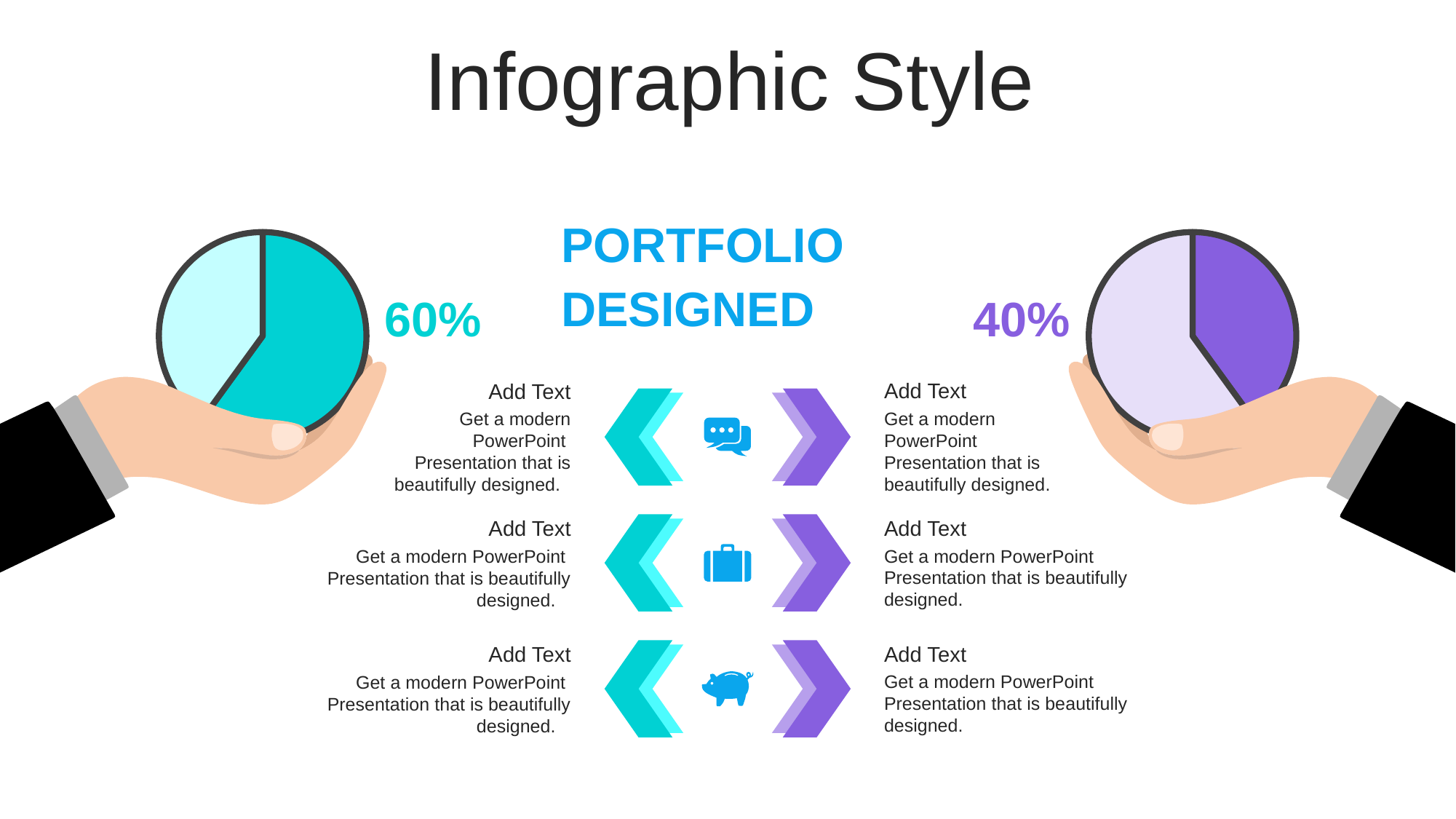
What kind of chart is shown on the right side of the slide? pie chart What kind of chart is shown on the left side of the slide? pie chart What is the difference between the percentage printed next to the left pie chart and the percentage printed next to the right pie chart? 20% What percentage is printed next to the left pie chart? 60% Which pie chart has the larger printed percentage, the left one or the right one? the left one What percentage is printed next to the right pie chart? 40% In the left pie chart, which slice is larger, the dark teal slice or the light teal slice? the dark teal slice What colour is the larger slice of the left pie chart? dark teal How many pie charts are on the slide? 2 In the right pie chart, which slice is larger, the dark purple slice or the light purple slice? the light purple slice How many slices does the right pie chart have? 2 How many slices does the left pie chart have? 2